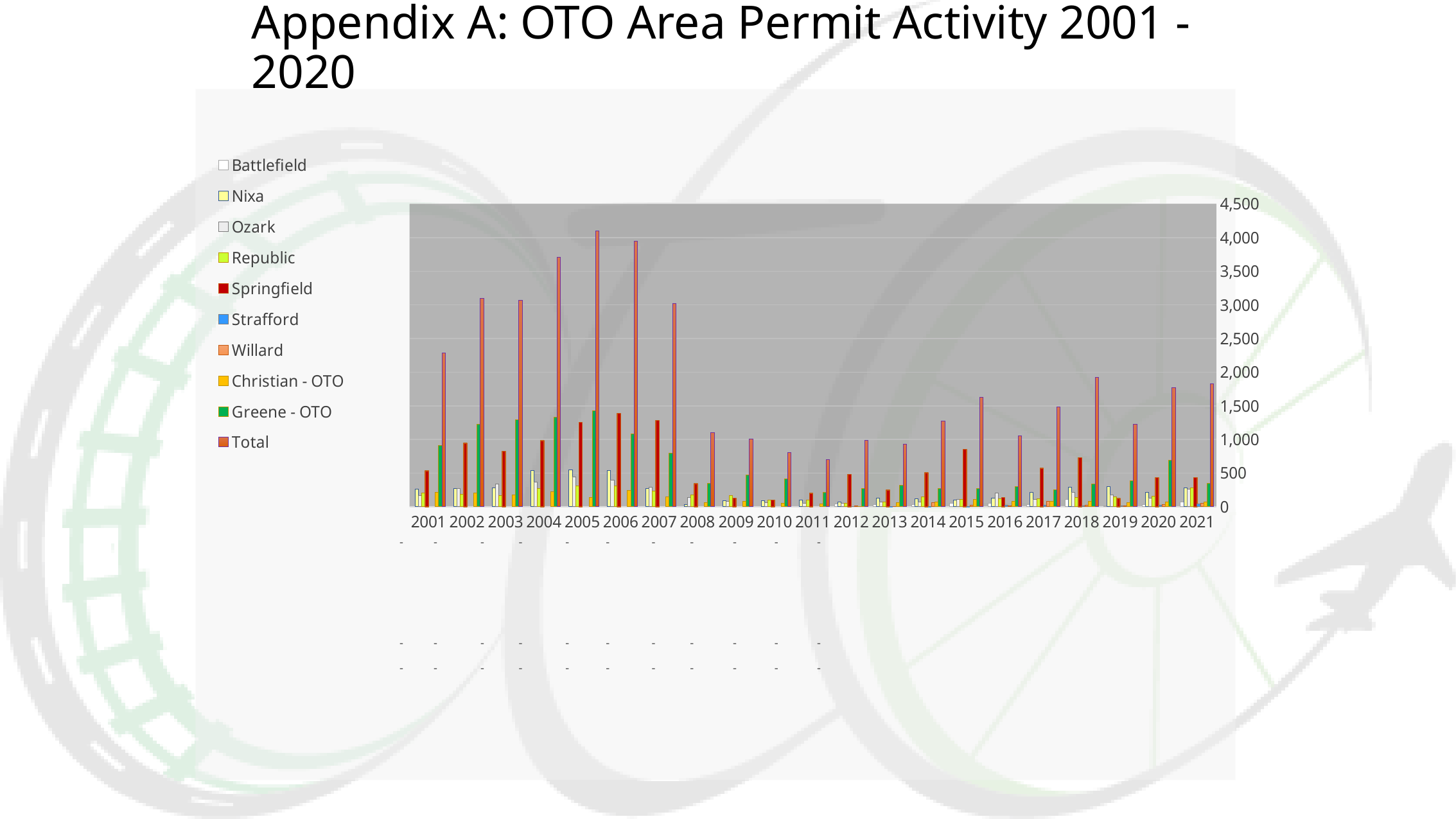
Which year has the larger Total value, 2007 or 2008? 2007 Is the Total value for 2005 greater or less than 3,500? greater Is the Greene - OTO value for 2005 greater or less than 1,000? greater How many series does the chart's legend list? 10 In which year is the Total bar highest? 2005 How many years are shown along the x axis of the chart? 21 Which year has the larger Total value, 2001 or 2002? 2002 What kind of chart is shown on the slide? bar chart Is the Total value for 2001 greater or less than 2,000? greater What is the title of the slide containing the chart? Appendix A: OTO Area Permit Activity 2001 - 2020 Does the Total value rise or fall from 2005 to 2011? fall